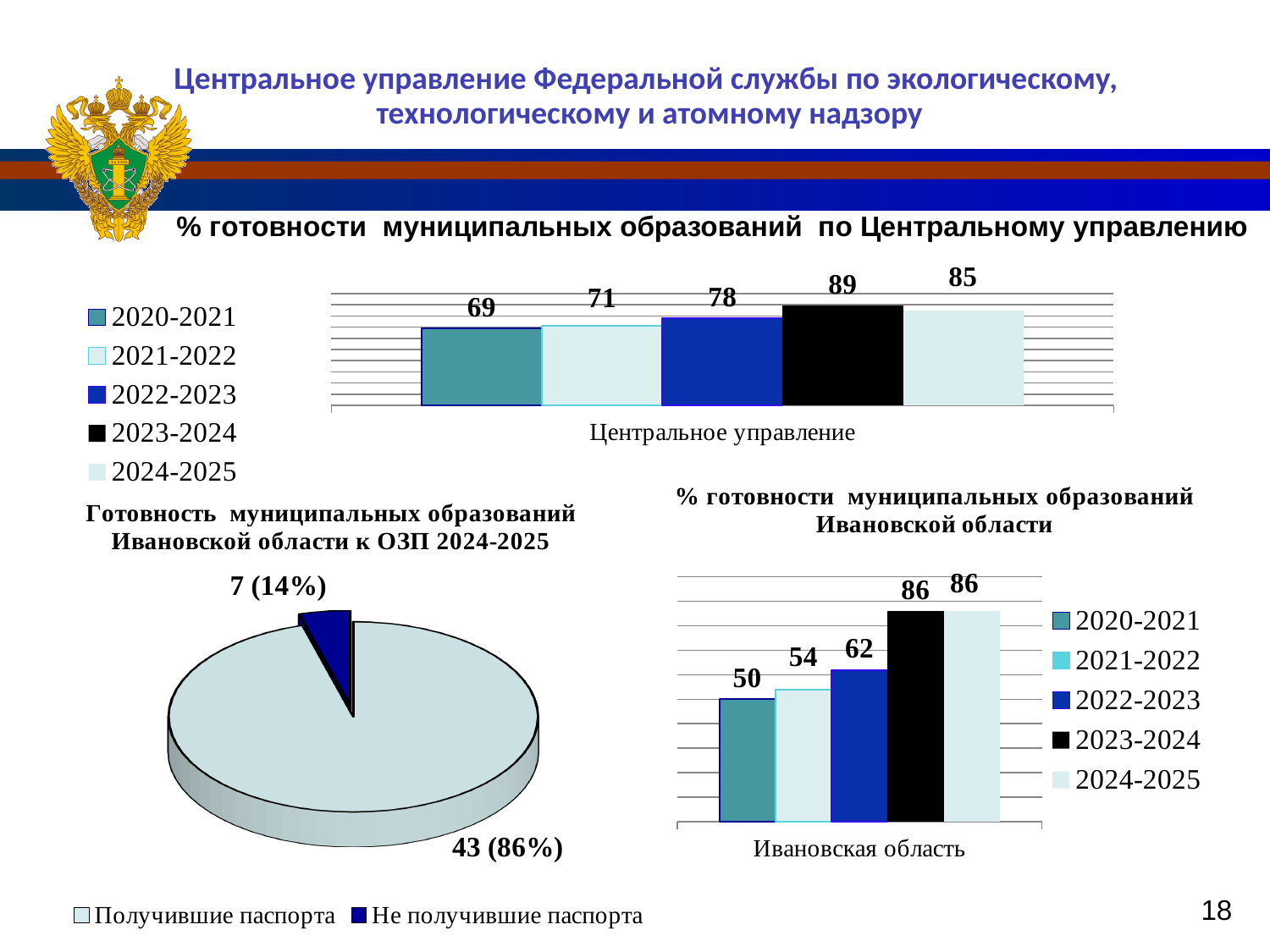
In the top chart '% готовности муниципальных образований по Центральному управлению', what is the difference between the 2023-2024 and 2024-2025 values? 4 In the bottom-left pie chart 'Готовность муниципальных образований Ивановской области к ОЗП 2024-2025', what share of the pie is 'Не получившие паспорта'? 14% In the top chart '% готовности муниципальных образований по Центральному управлению', how many series does the legend list? 5 In the bottom-right chart '% готовности муниципальных образований Ивановской области', do the values rise or fall from 2020-2021 to 2023-2024? rise In the bottom-right chart '% готовности муниципальных образований Ивановской области', what is the value for 2022-2023? 62 In the top chart '% готовности муниципальных образований по Центральному управлению', which series has the highest value? 2023-2024 In the bottom-right chart '% готовности муниципальных образований Ивановской области', what is the difference between the 2021-2022 and 2020-2021 values? 4 In the bottom-right chart '% готовности муниципальных образований Ивановской области', which series has the lowest value? 2020-2021 In the top chart '% готовности муниципальных образований по Центральному управлению', what is the value for 2020-2021? 69 In the bottom-left pie chart 'Готовность муниципальных образований Ивановской области к ОЗП 2024-2025', what is the value for 'Получившие паспорта'? 43 (86%) In the bottom-right chart '% готовности муниципальных образований Ивановской области', what kind of chart is it? bar chart In the bottom-left pie chart 'Готовность муниципальных образований Ивановской области к ОЗП 2024-2025', how many slices does the pie have? 2